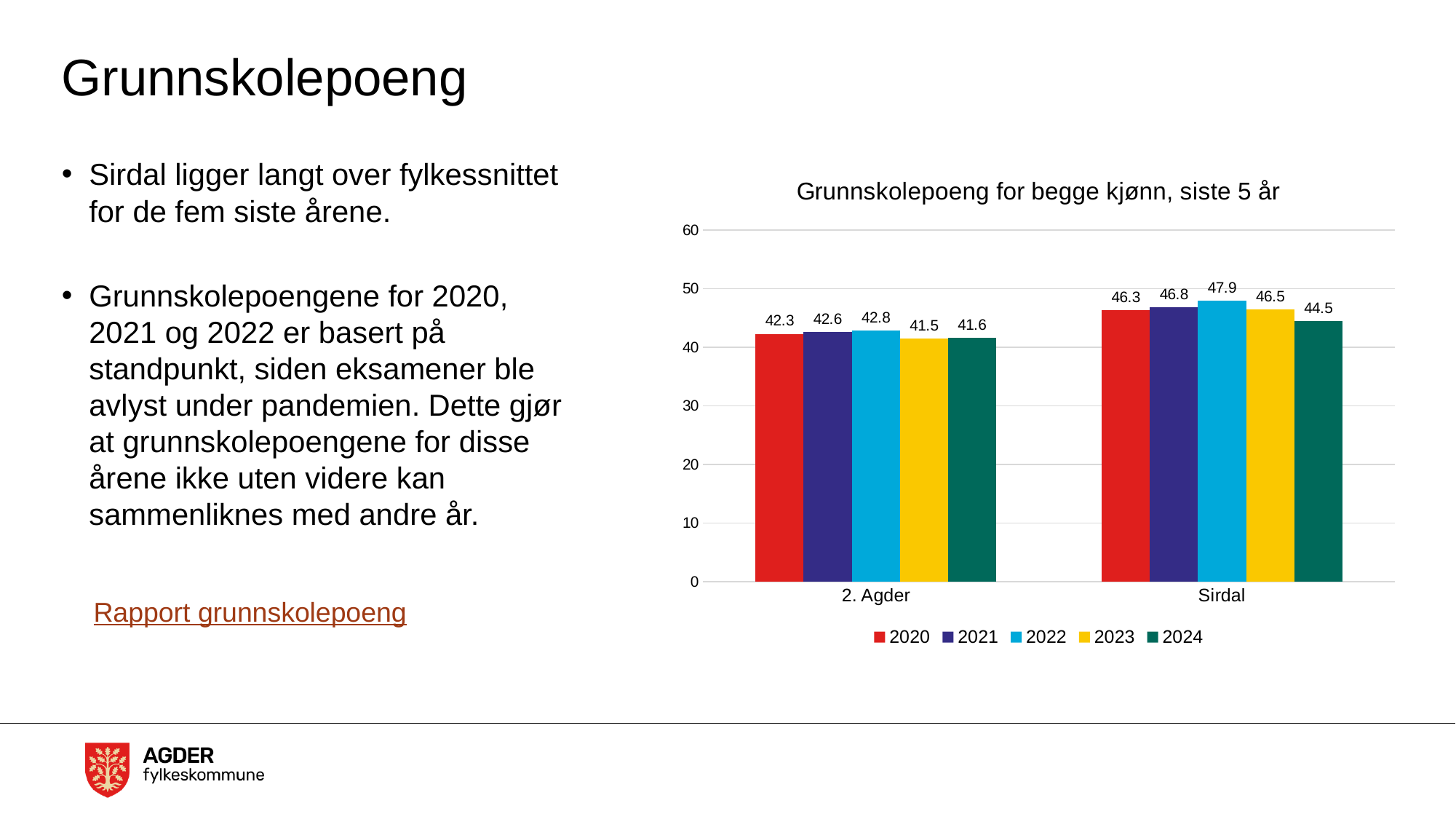
How many categories are shown on the x axis? 2 What kind of chart is shown on the slide? bar chart Which is larger, the 2020 value for Sirdal or the 2020 value for 2. Agder? Sirdal What is the value for 2. Agder in 2023? 41.5 What is the value for Sirdal in 2022? 47.9 What is the title of the chart? Grunnskolepoeng for begge kjønn, siste 5 år Which year has the lowest value for 2. Agder? 2023 What is the value for Sirdal in 2024? 44.5 Which year has the highest value for Sirdal? 2022 What is the difference between the Sirdal and 2. Agder values in 2022? 5.1 Is the value for Sirdal in 2021 greater or less than 40? greater How many series does the legend list? 5